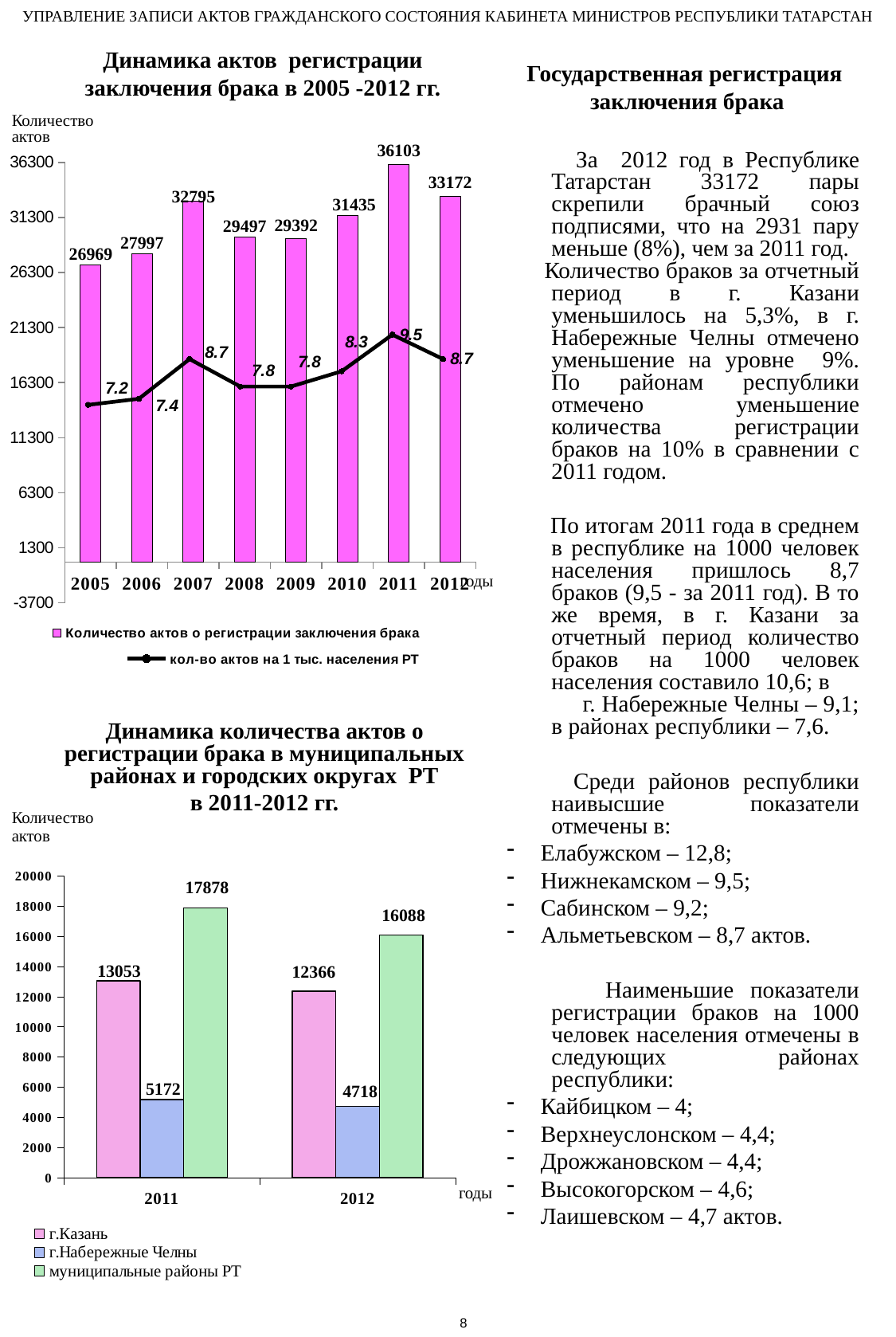
In the top chart, what is the value of the line 'кол-во актов на 1 тыс. населения РТ' for 2011? 9.5 In the top chart, what is the difference between the number of acts in 2011 and in 2012? 2931 In the top chart (Динамика актов регистрации заключения брака в 2005-2012 гг.), what is the number of marriage registration acts in 2007? 32795 In the bottom chart (Динамика количества актов о регистрации брака в муниципальных районах и городских округах РТ), what is the value for г.Набережные Челны in 2012? 4718 In the top chart, which year has the highest number of marriage registration acts? 2011 In the bottom chart, what is the difference between the values for муниципальные районы РТ in 2011 and 2012? 1790 In the top chart, how many series does the legend list? 2 In the bottom chart, which series has the highest value in 2011? муниципальные районы РТ In the top chart, which year has the lowest number of marriage registration acts? 2005 What type of chart is the bottom chart? bar chart In the top chart, how many years are shown on the x axis? 8 In the bottom chart, is the value for г.Казань in 2012 larger or smaller than in 2011? smaller